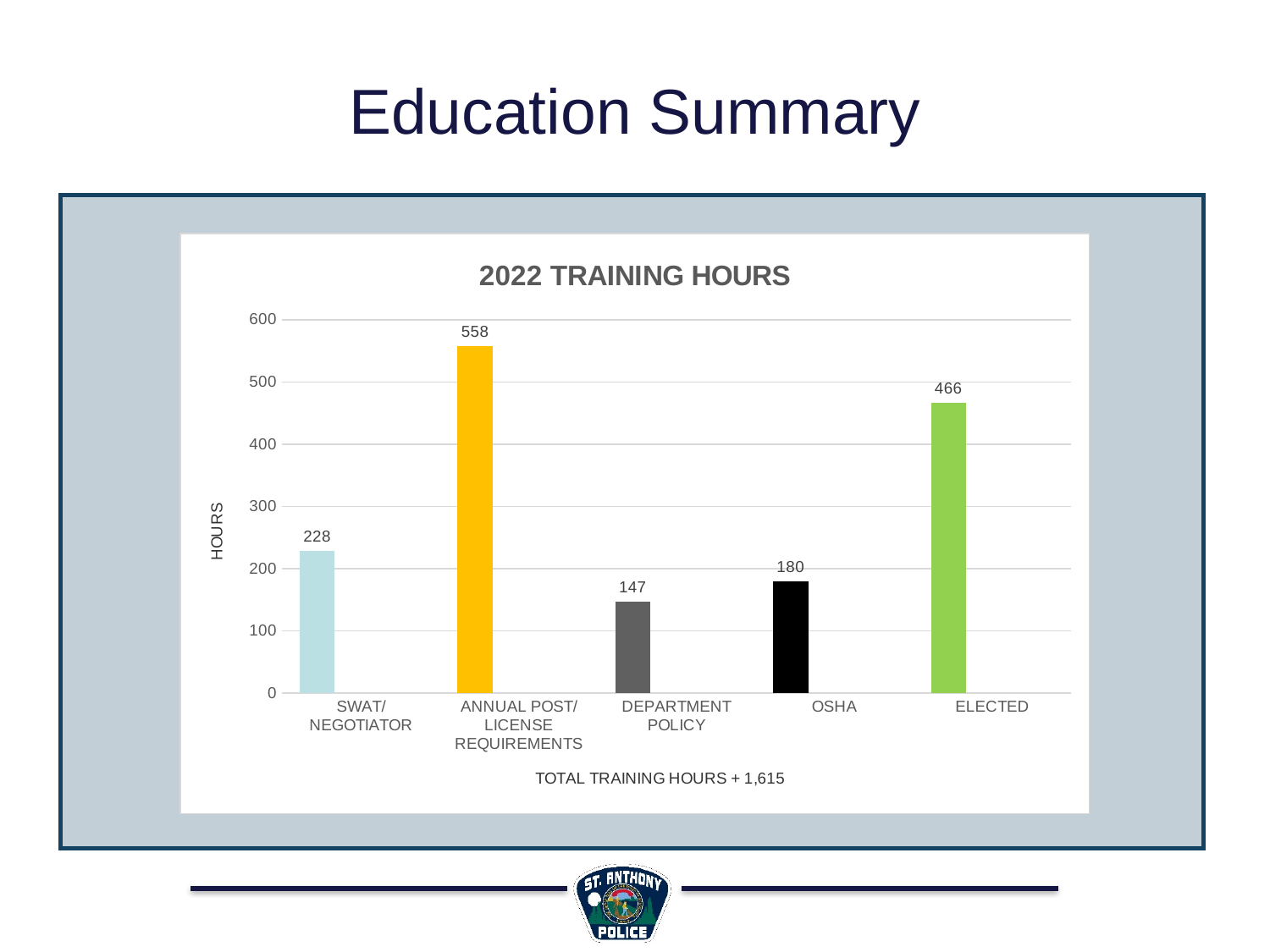
What is the title of the chart? 2022 TRAINING HOURS Which category has the lowest number of training hours? DEPARTMENT POLICY What is the value for SWAT/NEGOTIATOR in the 2022 Training Hours chart? 228 How many categories are shown on the x axis of the chart? 5 What is the difference in hours between ELECTED and OSHA? 286 Which category has the highest number of training hours? ANNUAL POST/LICENSE REQUIREMENTS Which is larger, the value for SWAT/NEGOTIATOR or the value for DEPARTMENT POLICY? SWAT/NEGOTIATOR What kind of chart is shown on the slide? Bar chart Is the value for ELECTED greater or less than 400? greater What is the label on the vertical axis of the chart? HOURS How many training hours are shown for ANNUAL POST/LICENSE REQUIREMENTS? 558 What is the value for OSHA? 180